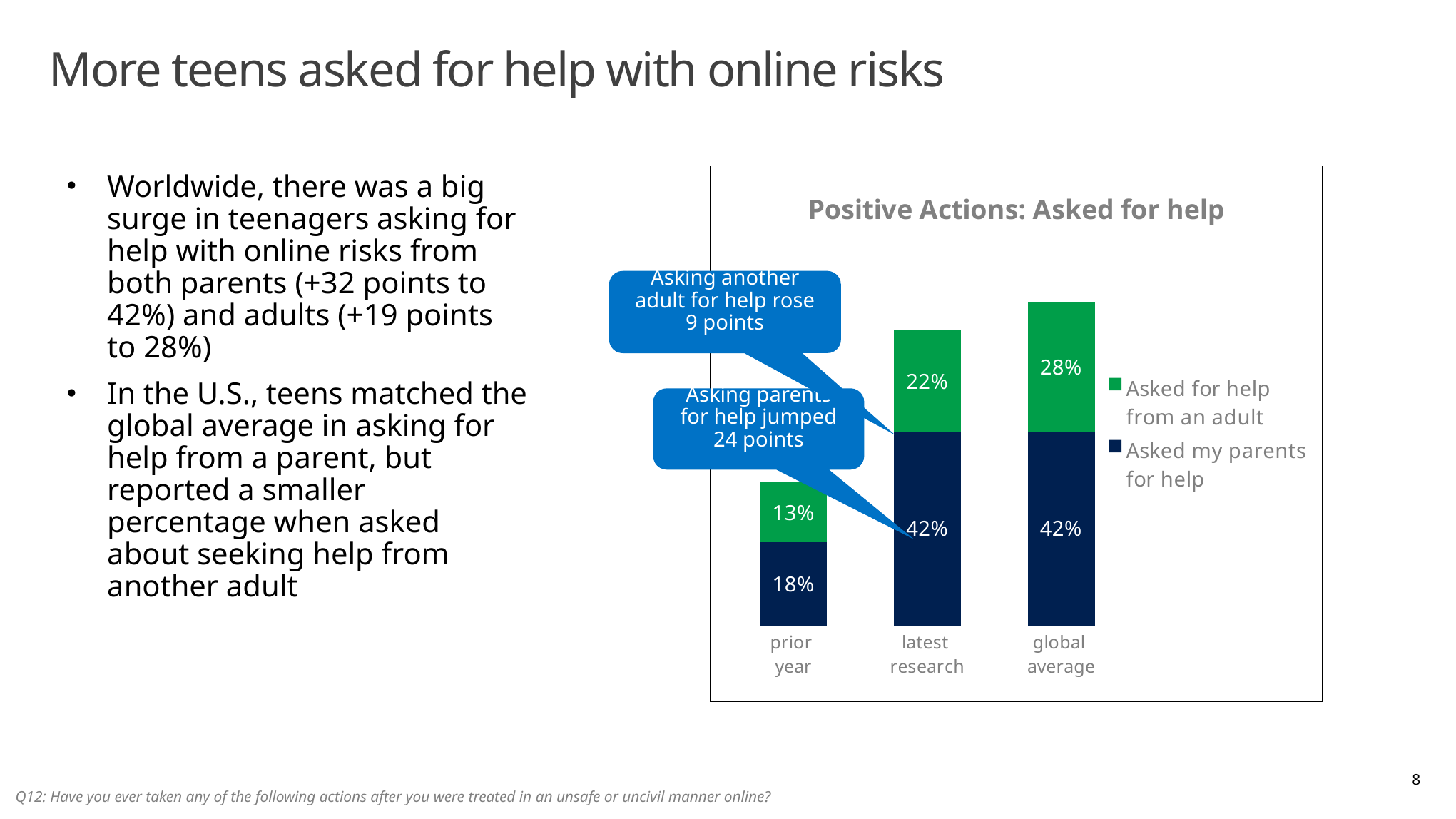
What percentage asked their parents for help in the prior year? 18% What is the title of the chart? Positive Actions: Asked for help How many categories are shown on the x axis of the chart? 3 What kind of chart is shown on the slide? Stacked bar chart How many series does the chart legend list? 2 What is the total of the stacked bar for the prior year? 31% Which category has the lowest value for asking parents for help? prior year What is the difference between the latest research and prior year values for asking parents for help? 24 points What percentage asked for help from an adult in the latest research? 22% What is the global average for asking for help from an adult? 28% Which is larger: asking for help from an adult in the latest research or in the global average? global average What is the total of the stacked bar for the global average? 70%